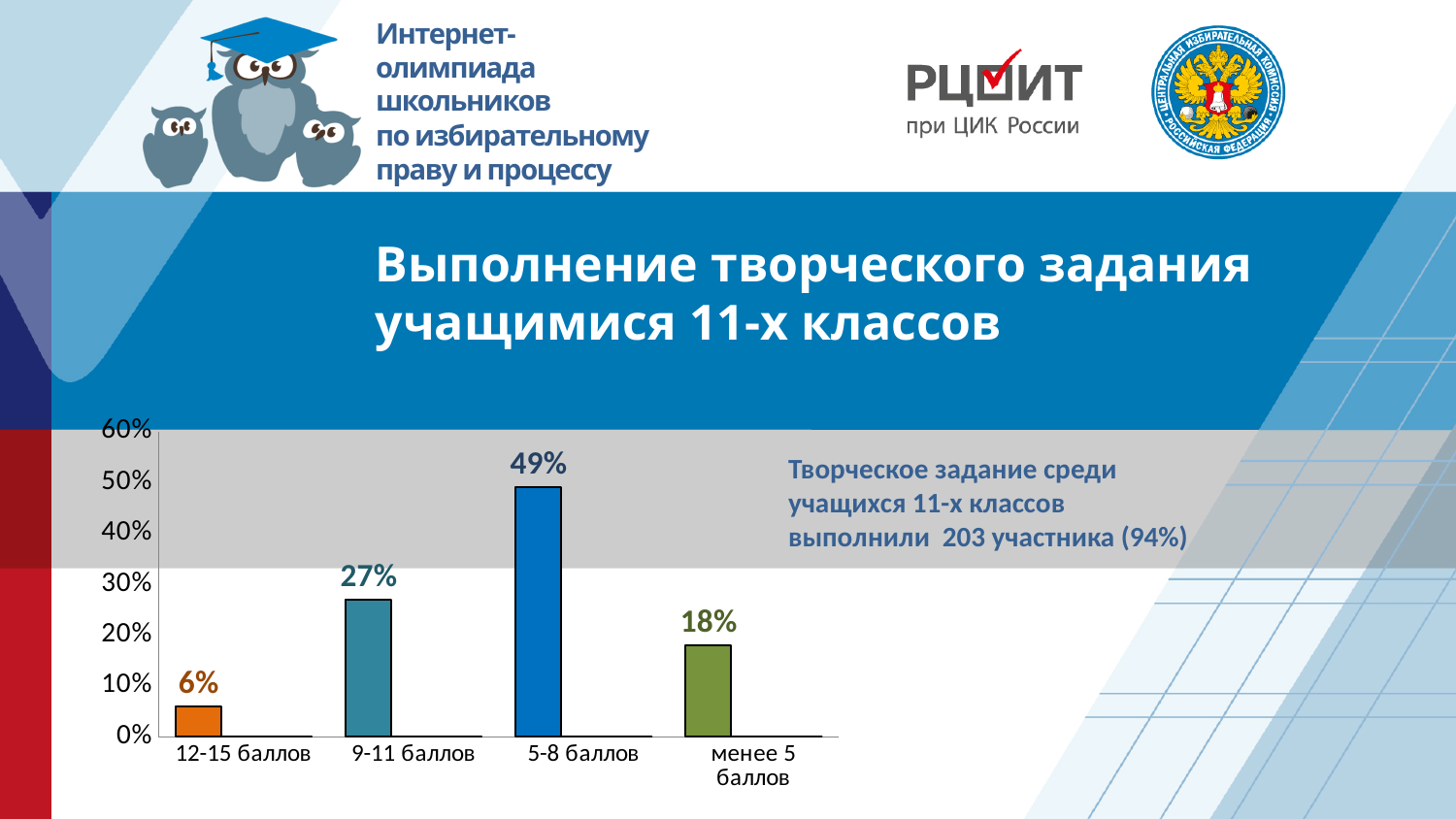
Which category has the lowest value? 12-15 баллов What is the value for the "12-15 баллов" category? 6% Which category has the highest value? 5-8 баллов How many categories are shown on the x axis of the chart? 4 What is the highest value shown on the y axis of the chart? 60% What kind of chart is shown on the slide? bar chart What is the value for the "менее 5 баллов" category? 18% Which is larger: the value for "9-11 баллов" or the value for "менее 5 баллов"? 9-11 баллов What is the value for the "5-8 баллов" category? 49% Is the value for "5-8 баллов" greater or less than 40%? greater What is the value for the "9-11 баллов" category? 27% What is the difference between the values for "5-8 баллов" and "9-11 баллов"? 22%